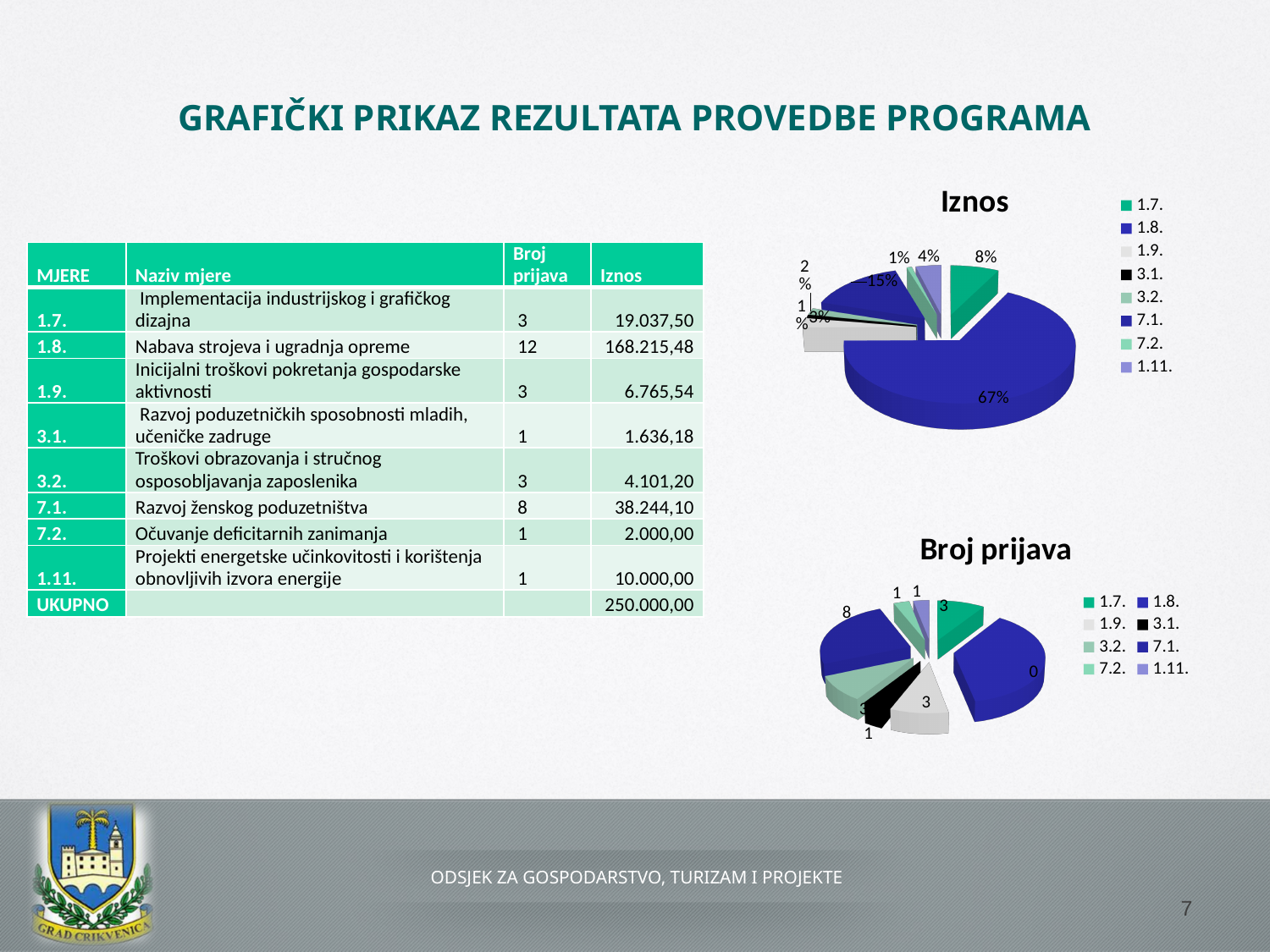
How many entries does the legend of the "Iznos" chart list? 8 In the "Iznos" chart, what share of the pie does 7.1. have? 15% In the "Broj prijava" chart, what is the value for 1.7.? 3 In the "Iznos" chart, what share of the pie does 1.11. have? 4% What kind of chart is the "Iznos" chart? pie chart In the "Iznos" chart, which measure has the largest slice? 1.8. In the "Broj prijava" chart, which is larger, the value for 7.1. or the value for 1.7.? 7.1. In the "Broj prijava" chart, what is the value for 7.1.? 8 In the "Iznos" chart, what share of the pie does 1.7. have? 8% What kind of chart is the "Broj prijava" chart? pie chart How many slices does the "Broj prijava" chart have? 8